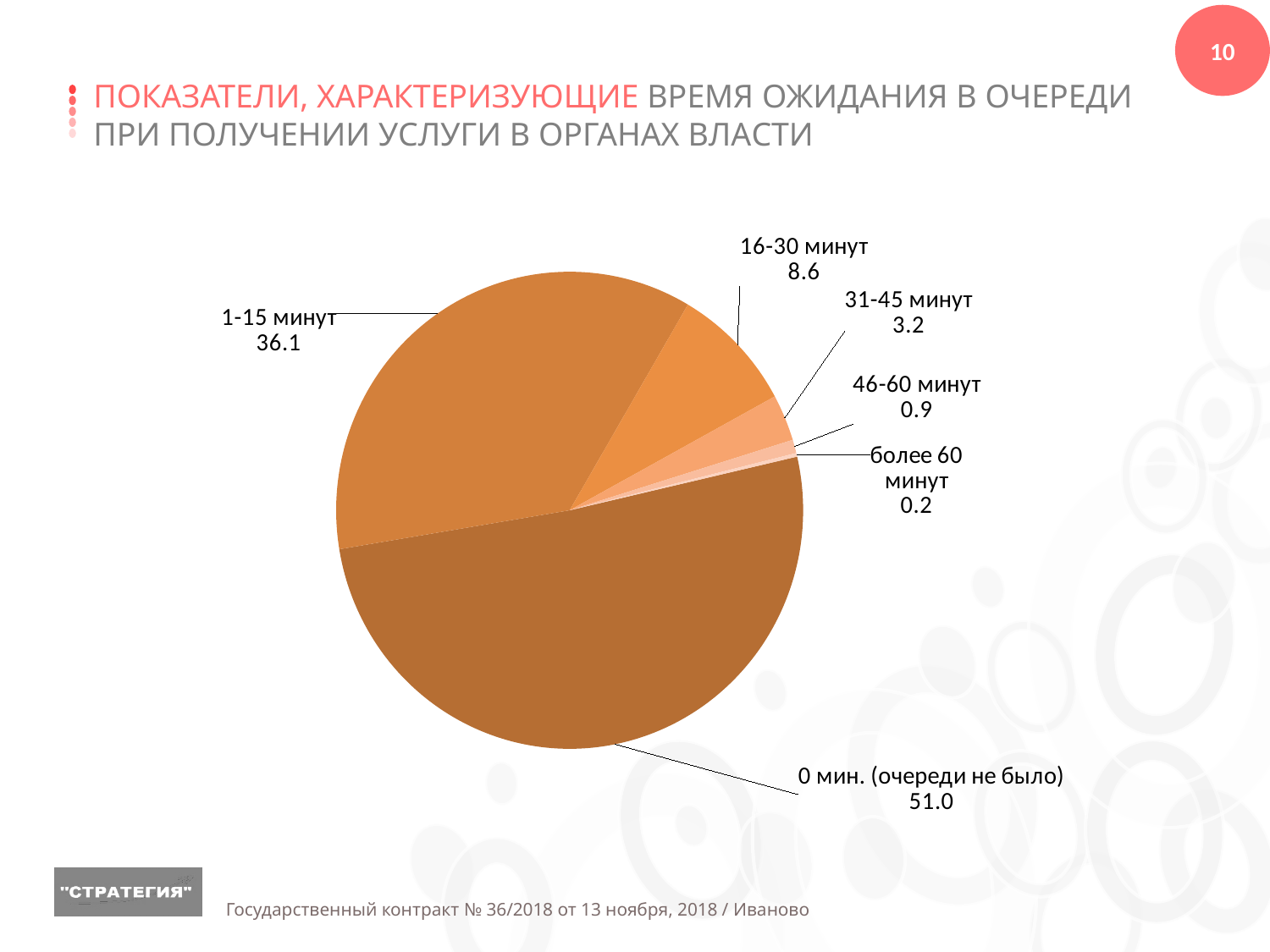
How many slices does the pie chart have? 6 What is the difference between the values for "0 мин. (очереди не было)" and "1-15 минут"? 14.9 What is the value for the slice "1-15 минут"? 36.1 What is the value for the slice "31-45 минут"? 3.2 What kind of chart is shown on the slide? pie chart What is the value for the slice "46-60 минут"? 0.9 Which slice of the pie is the largest? 0 мин. (очереди не было) Which slice of the pie is the smallest? более 60 минут What is the value for the slice "0 мин. (очереди не было)"? 51.0 What is the value for the slice "более 60 минут"? 0.2 Which is larger, the value for "16-30 минут" or the value for "31-45 минут"? 16-30 минут What is the value for the slice "16-30 минут"? 8.6